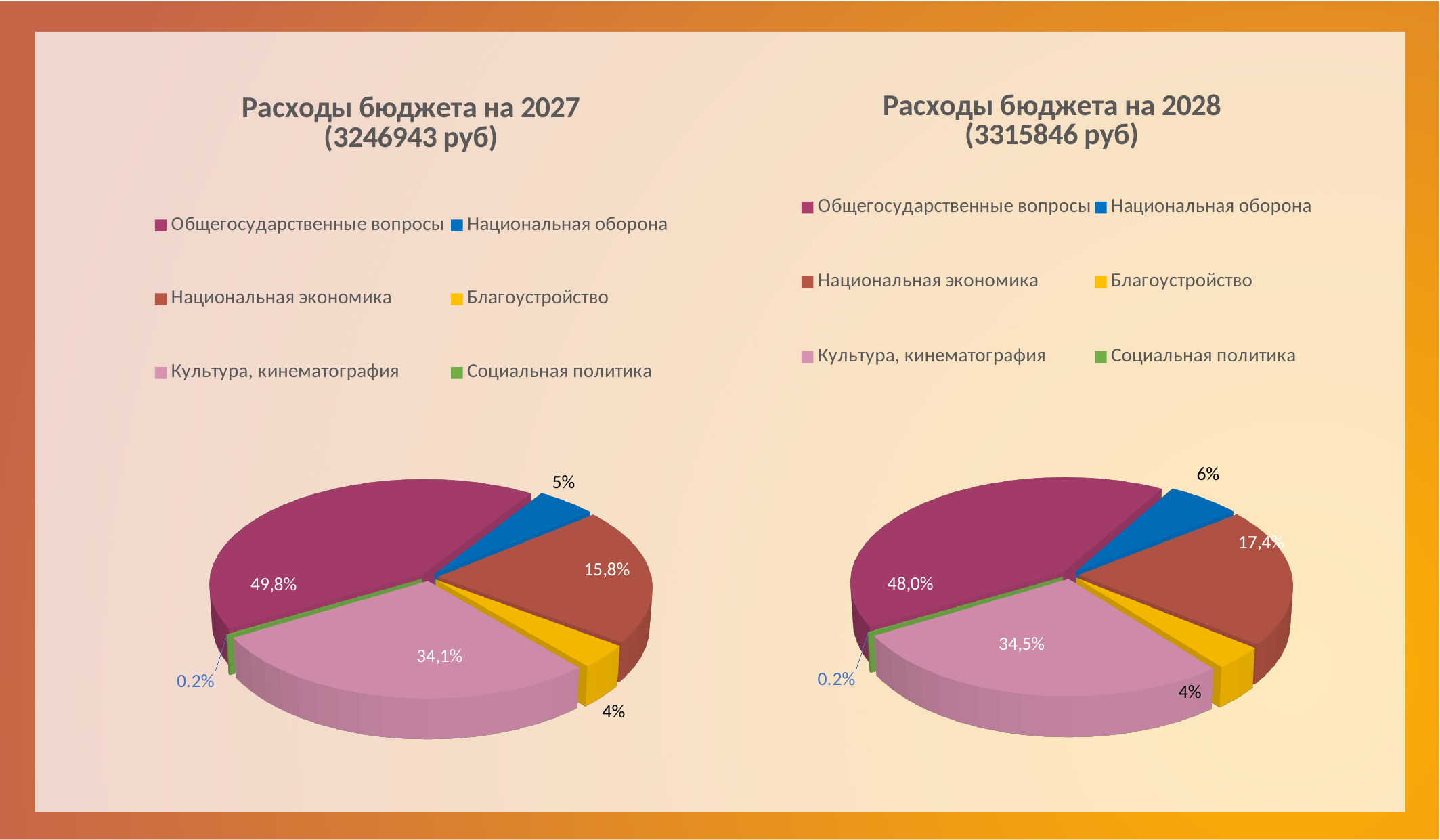
In the chart titled "Расходы бюджета на 2028", what colour is the Благоустройство slice? Yellow In the chart titled "Расходы бюджета на 2027", what share does Общегосударственные вопросы have? 49,8% In the chart titled "Расходы бюджета на 2028", what share does Культура, кинематография have? 34,5% In the chart titled "Расходы бюджета на 2027", what is the value for Национальная экономика? 15,8% In the chart titled "Расходы бюджета на 2027", which category has the smallest slice? Социальная политика In the chart titled "Расходы бюджета на 2028", what is the value for Национальная оборона? 6% How many slices does the chart titled "Расходы бюджета на 2027" have? 6 What type of chart is the chart titled "Расходы бюджета на 2028"? Pie chart In the chart titled "Расходы бюджета на 2028", which is larger: Национальная экономика or Национальная оборона? Национальная экономика In the chart titled "Расходы бюджета на 2028", which category has the largest slice? Общегосударственные вопросы In the chart titled "Расходы бюджета на 2027", what is the difference between the shares of Общегосударственные вопросы and Культура, кинематография? 15,7% What total budget amount is shown in the title of the left chart? 3246943 руб